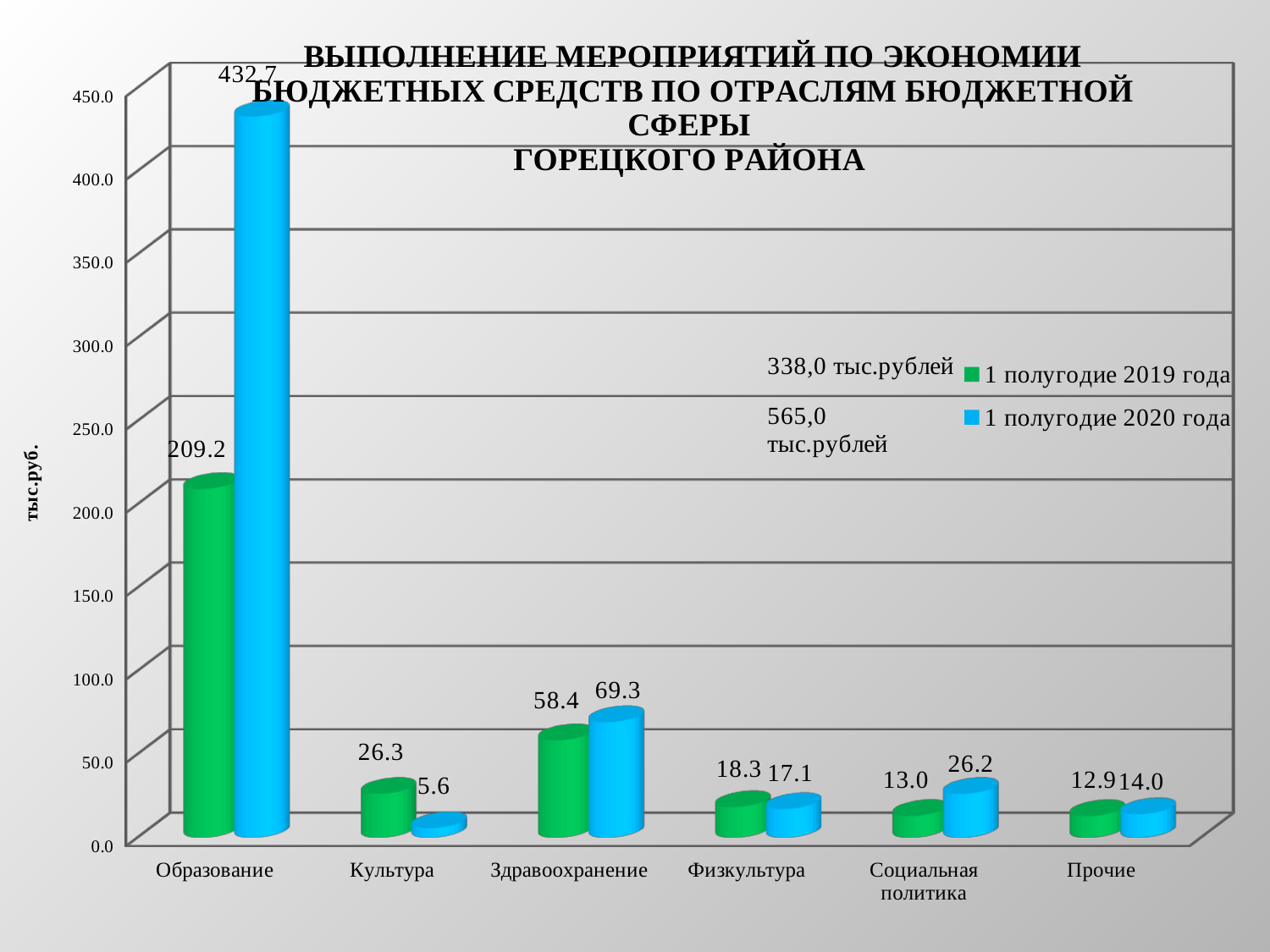
For Здравоохранение, which series has the larger value: 1 полугодие 2019 года or 1 полугодие 2020 года? 1 полугодие 2020 года How many categories are shown on the x axis? 6 Which category has the highest value in the series 1 полугодие 2019 года? Образование How many series does the legend list? 2 What is the value for Образование in the series 1 полугодие 2020 года? 432.7 What is the value for Культура in the series 1 полугодие 2019 года? 26.3 Which category has the lowest value in the series 1 полугодие 2020 года? Культура What is the value for Социальная политика in the series 1 полугодие 2020 года? 26.2 What kind of chart is shown on the slide? bar chart What is the difference between the 1 полугодие 2020 года and 1 полугодие 2019 года values for Образование? 223.5 Is the value for Образование in the series 1 полугодие 2019 года greater or less than 200.0? greater What is the label of the vertical axis? тыс.руб.